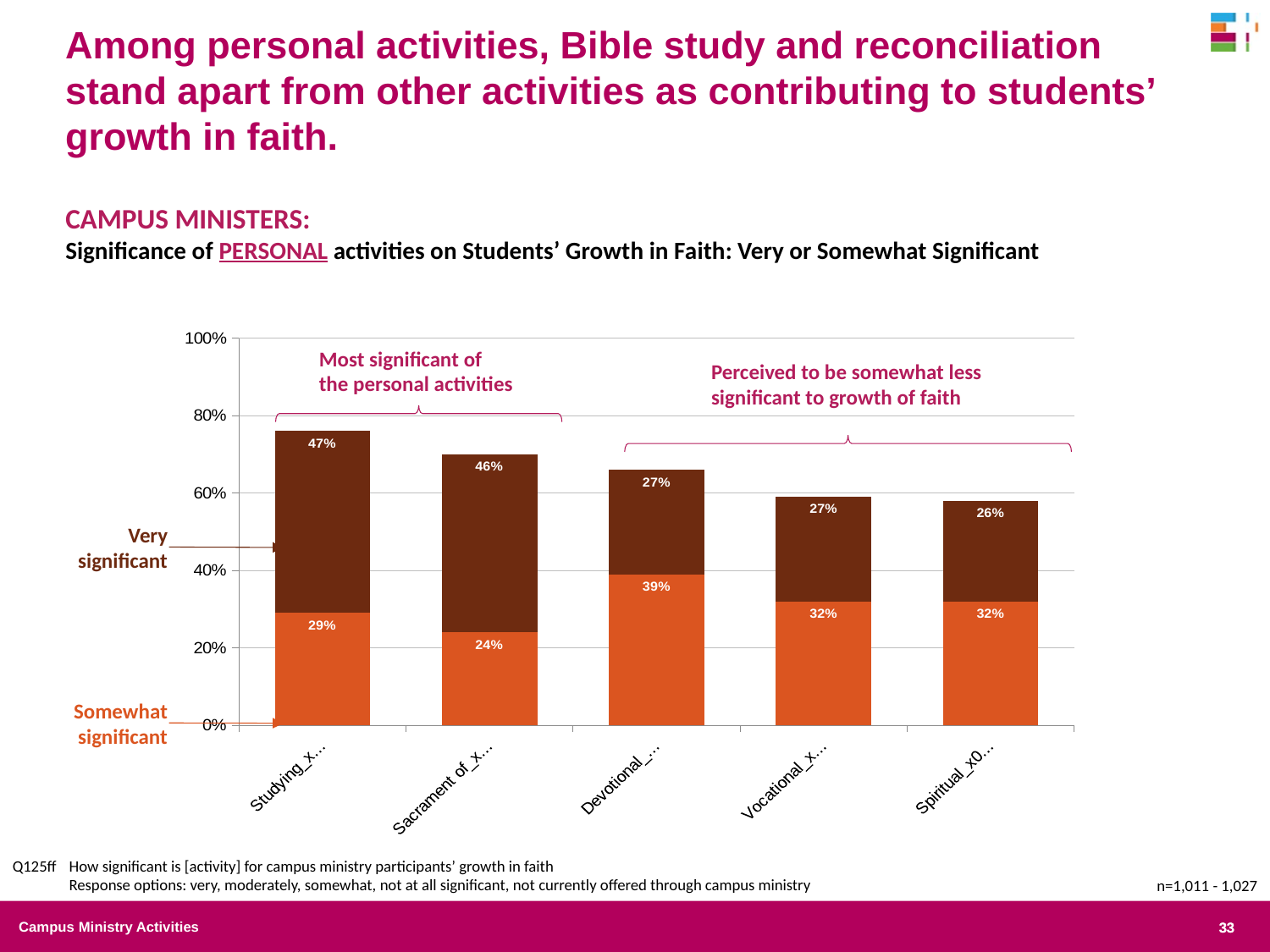
What is the difference between the 'Very significant' values of the first bar (Studying...) and the third bar (Devotional...)? 20 percentage points What type of chart is shown on the slide? Stacked bar chart What is the 'Very significant' value for the first bar (Studying...)? 47% What is the 'Somewhat significant' value for the third bar (Devotional...)? 39% How many bars (activities) are plotted in the chart? 5 Which has the larger 'Somewhat significant' value: the first bar (Studying...) or the third bar (Devotional...)? Devotional... (39%) What is the combined total (Very + Somewhat significant) for the first bar (Studying...)? 76% Which bar has the highest 'Very significant' value? Studying... (first bar), 47% What is the combined total (Very + Somewhat significant) for the third bar (Devotional...)? 66% Which bar has the lowest 'Very significant' value? Spiritual... (last bar), 26% What is the 'Somewhat significant' value for the second bar (Sacrament of...)? 24% Which colour represents the 'Very significant' segment in the chart? Dark brown (top segment)